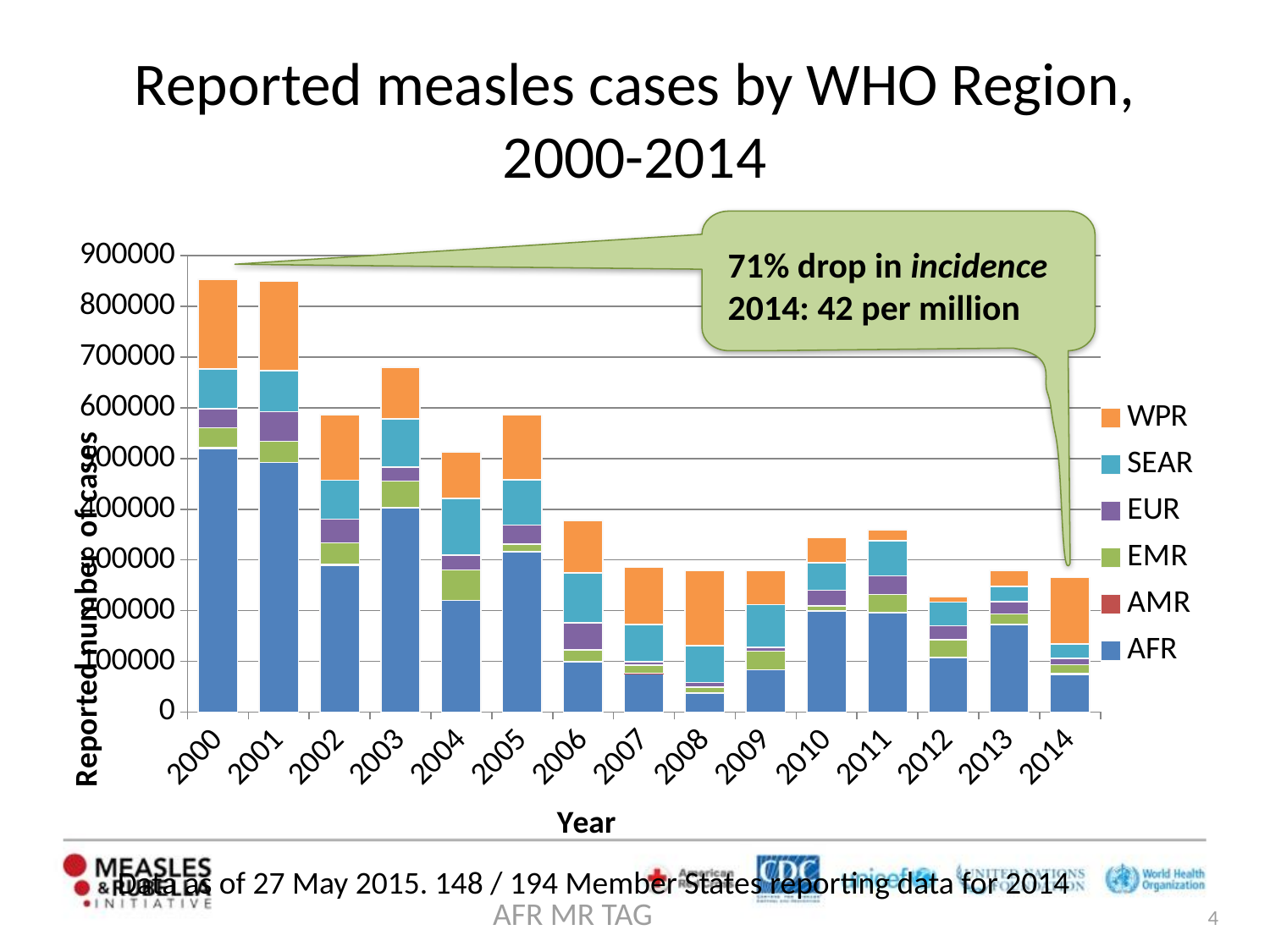
Which year has a higher total of reported measles cases, 2003 or 2004? 2003 How many years are shown along the x axis of the chart? 15 What kind of chart is shown on the slide? Stacked bar chart Which WHO region is shown in orange in the chart legend? WPR Is the total number of reported measles cases in 2012 greater or less than 300000? less Is the total number of reported measles cases in 2005 greater or less than 500000? greater How many WHO regions does the chart legend list? 6 Is the total number of reported measles cases in 2000 greater or less than 800000? greater Which year has the lowest total number of reported measles cases? 2012 Overall, do the total reported measles cases rise or fall from 2000 to 2014? Fall